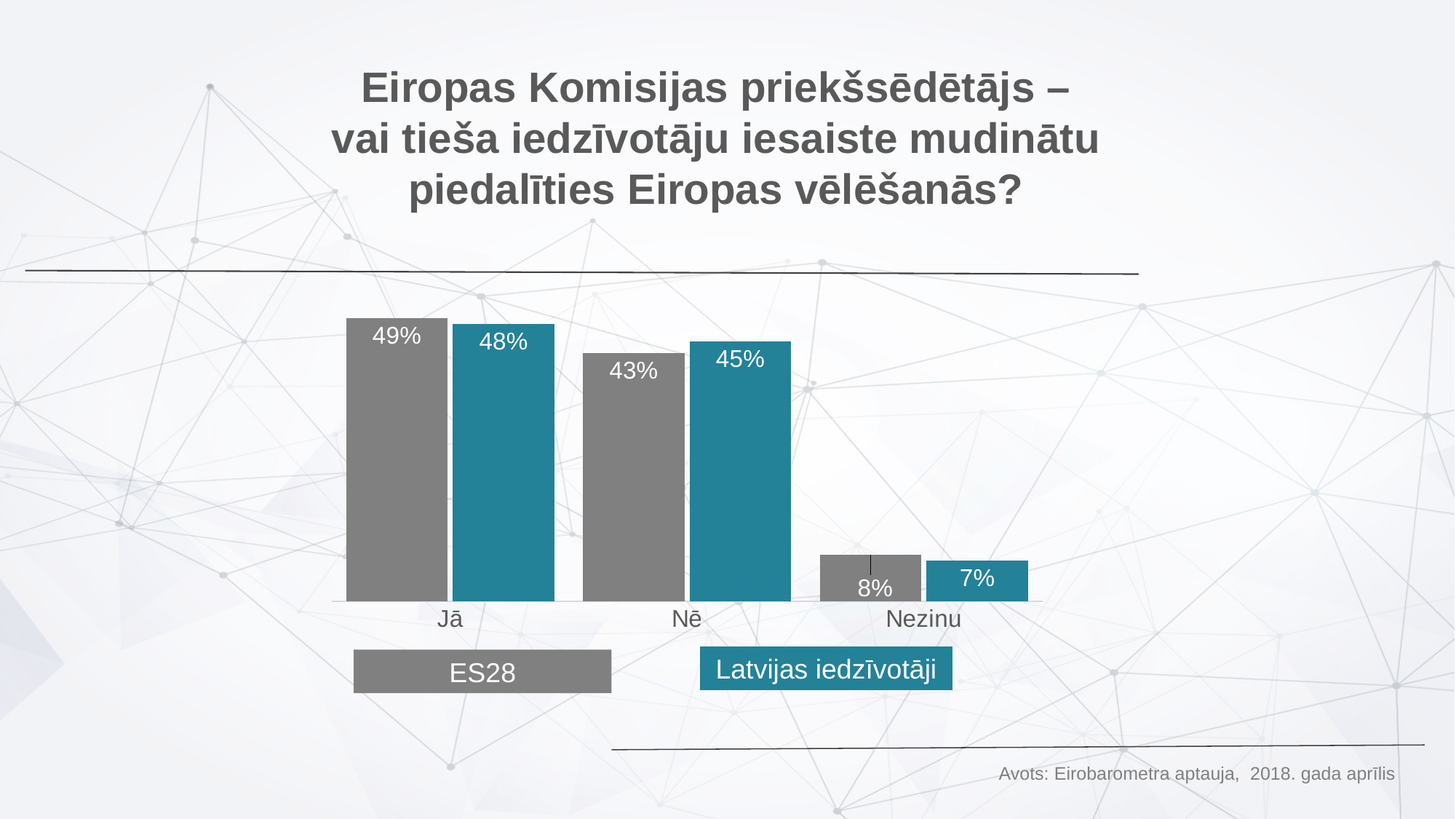
What is the difference between the ES28 and Latvijas iedzīvotāji values in the Nē category? 2% What kind of chart is shown on the slide? Bar chart What colour are the bars for the Latvijas iedzīvotāji series? Teal What is the value for Latvijas iedzīvotāji in the Jā category? 48% What is the value for ES28 in the Jā category? 49% What is the value for ES28 in the Nezinu category? 8% How many series does the legend list? 2 Which category has the highest value for ES28? Jā In the Nē category, which series has the larger value, ES28 or Latvijas iedzīvotāji? Latvijas iedzīvotāji How many categories are shown on the x axis? 3 What is the value for Latvijas iedzīvotāji in the Nē category? 45% Which category has the lowest value for Latvijas iedzīvotāji? Nezinu